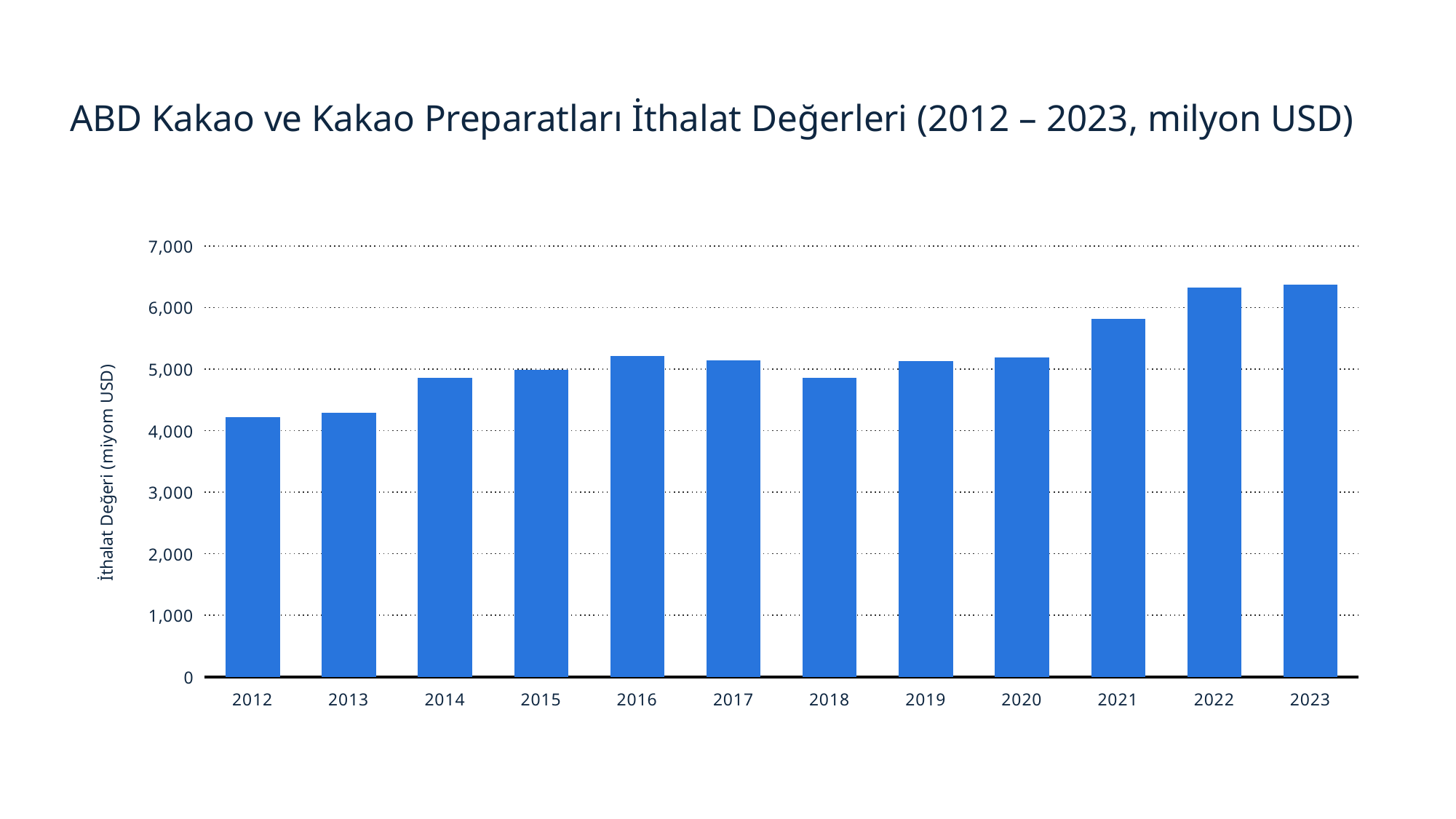
Is the value for 2022 greater or less than 6,000? greater What kind of chart is shown on the slide? bar chart Is the value for 2016 greater or less than 5,000? greater How many years (bars) are plotted on the chart? 12 Is the value for 2018 greater or less than 5,000? less Which year has the lowest import value? 2012 Which is larger, the value for 2014 or the value for 2016? 2016 Do the import values generally rise or fall from 2012 to 2023? rise Which is larger, the value for 2021 or the value for 2022? 2022 What is the title of the chart? ABD Kakao ve Kakao Preparatları İthalat Değerleri (2012 – 2023, milyon USD)